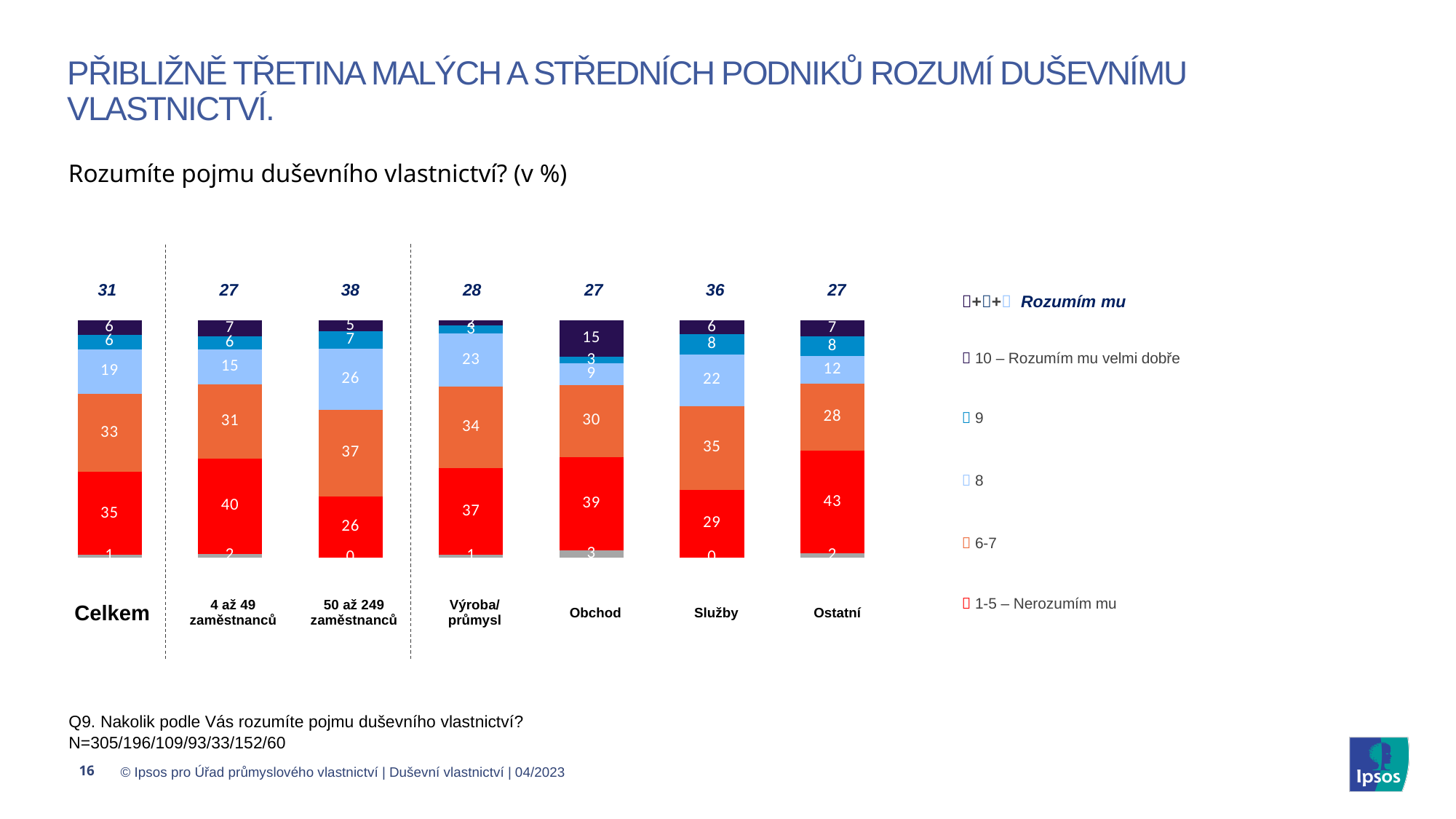
How many entries does the legend list? 5 What kind of chart is shown on the slide? Stacked bar chart What is the value of the '1-5 – Nerozumím mu' segment for Ostatní? 43 Which category has the lowest value for the '1-5 – Nerozumím mu' segment? 50 až 249 zaměstnanců What is the value of the '10 – Rozumím mu velmi dobře' segment for Obchod? 15 Which has a larger '6-7' segment, Služby or Obchod? Služby What is the difference between the 'Rozumím mu' total for Služby and for Celkem? 5 What is the 'Rozumím mu' total shown above the bar for 4 až 49 zaměstnanců? 27 Which category has the highest 'Rozumím mu' total shown above the bars? 50 až 249 zaměstnanců What is the value of the '1-5 – Nerozumím mu' segment for Celkem? 35 How many categories (bars) are shown in the chart? 7 What is the value of the '8' segment for 50 až 249 zaměstnanců? 26